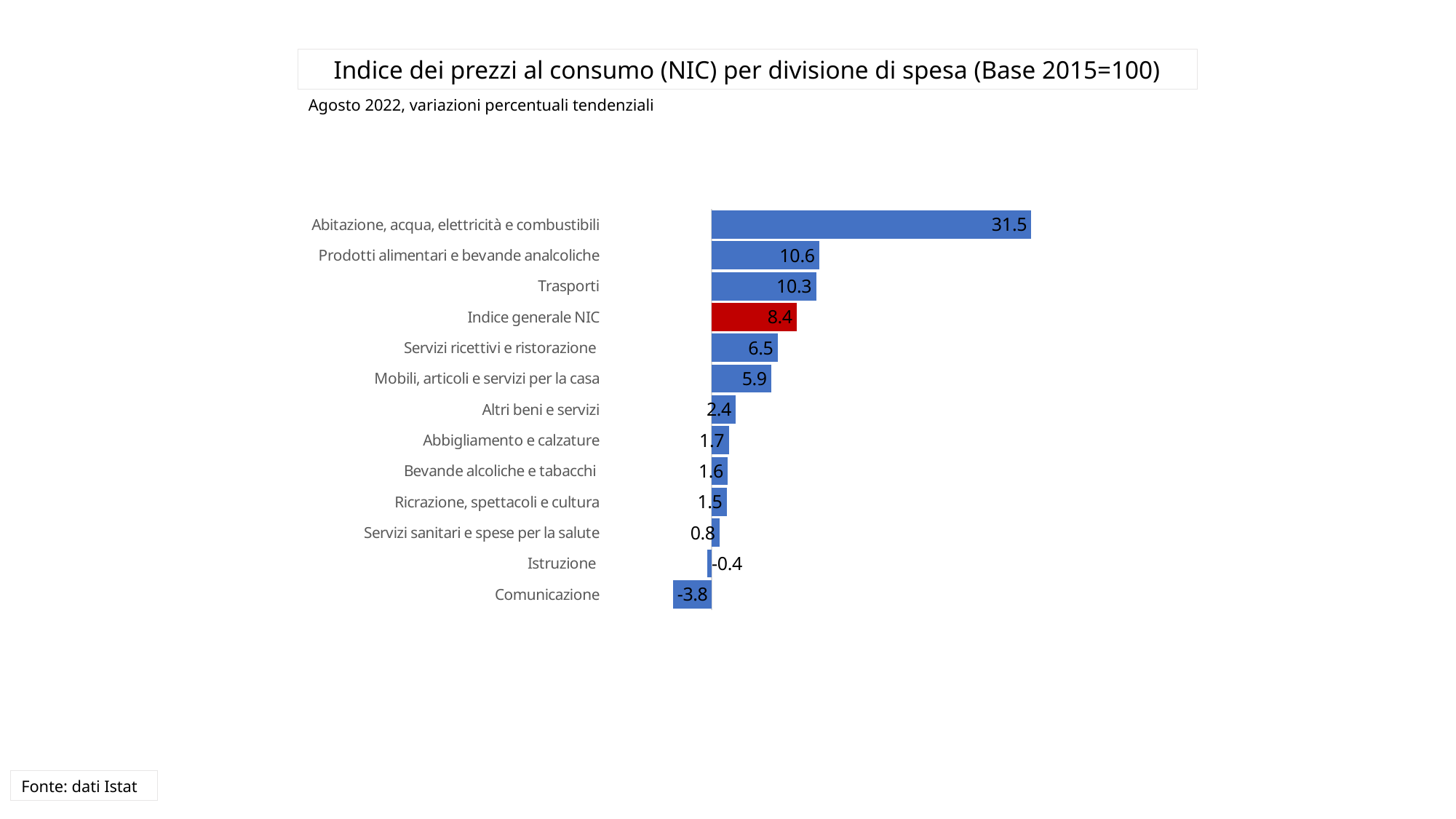
Which is larger, the value for Servizi ricettivi e ristorazione or the value for Mobili, articoli e servizi per la casa? Servizi ricettivi e ristorazione What is the difference between the values for Prodotti alimentari e bevande analcoliche and Trasporti? 0.3 What is the value for Indice generale NIC? 8.4 Which category has the lowest value? Comunicazione What is the value for Servizi sanitari e spese per la salute? 0.8 What is the difference between the values for Abitazione, acqua, elettricità e combustibili and Indice generale NIC? 23.1 How many categories are shown in the chart? 13 Which bar is coloured red instead of blue? Indice generale NIC What is the value for Abitazione, acqua, elettricità e combustibili? 31.5 What is the value for Comunicazione? -3.8 Which category has the highest value? Abitazione, acqua, elettricità e combustibili What kind of chart is shown on the slide? Bar chart